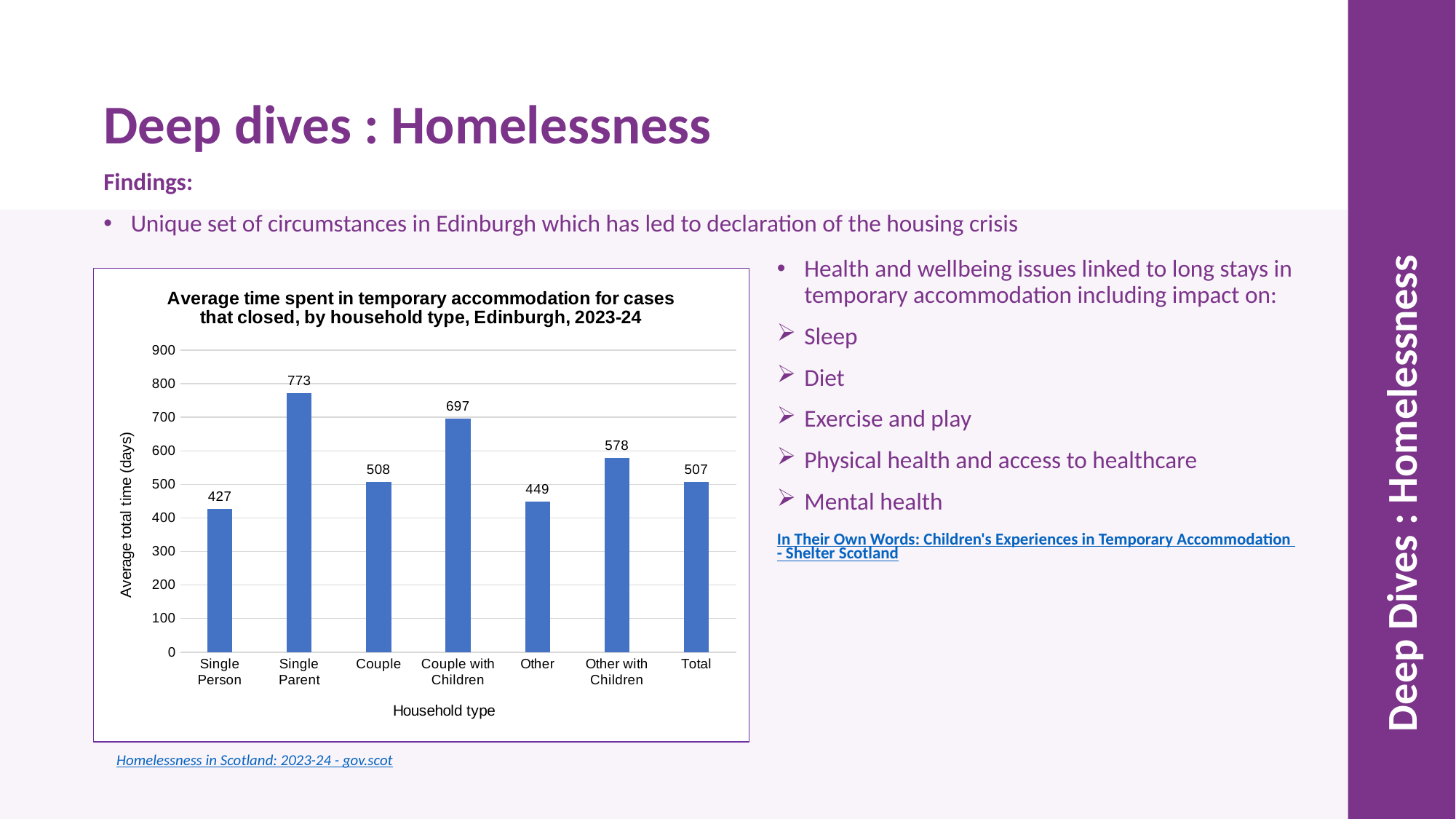
Is the value for Other with Children greater or less than 500? greater What is the difference between the values for Single Parent and Single Person? 346 What is the label of the y axis of the chart? Average total time (days) How many household type categories are shown on the x axis? 7 What is the difference between the values for Other with Children and Other? 129 Which household type has the lowest average time in temporary accommodation? Single Person What is the value shown for the Total category? 507 What kind of chart is shown on the slide? Bar chart What is the average total time in temporary accommodation for Couple with Children households? 697 Which household type has the highest average time in temporary accommodation? Single Parent What is the average total time in temporary accommodation for Single Parent households? 773 Which is larger, the value for Couple or the value for Other? Couple